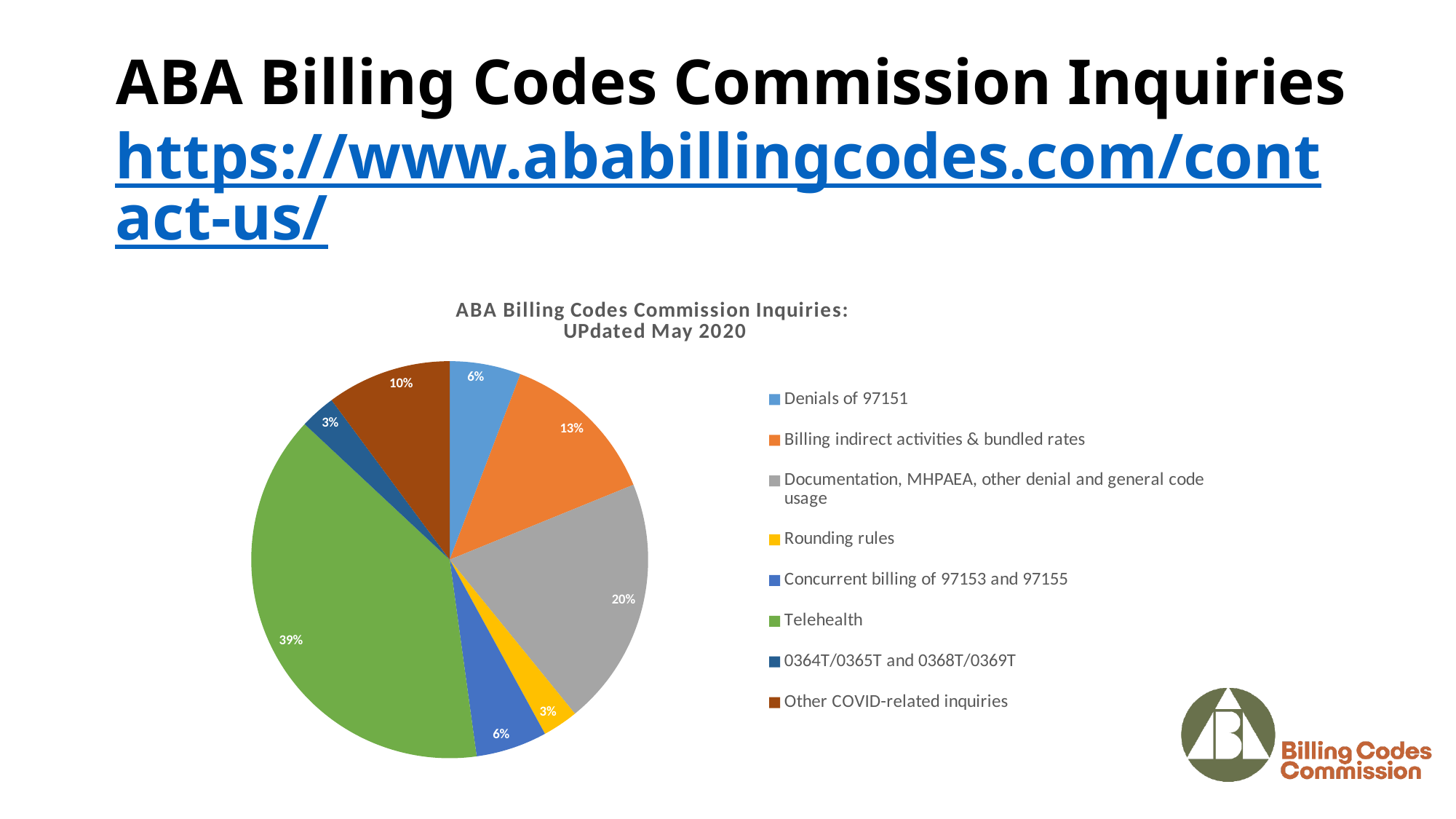
What share of inquiries is Other COVID-related inquiries? 10% What colour is the Telehealth slice? Green Which category has the largest share of inquiries? Telehealth What is the title of the chart? ABA Billing Codes Commission Inquiries: UPdated May 2020 What share of inquiries is Rounding rules? 3% How many categories does the legend list? 8 What share of inquiries is Documentation, MHPAEA, other denial and general code usage? 20% What kind of chart is shown on the slide? Pie chart What is the difference in percentage points between Telehealth and Documentation, MHPAEA, other denial and general code usage? 19 Which is larger: Billing indirect activities & bundled rates or Other COVID-related inquiries? Billing indirect activities & bundled rates